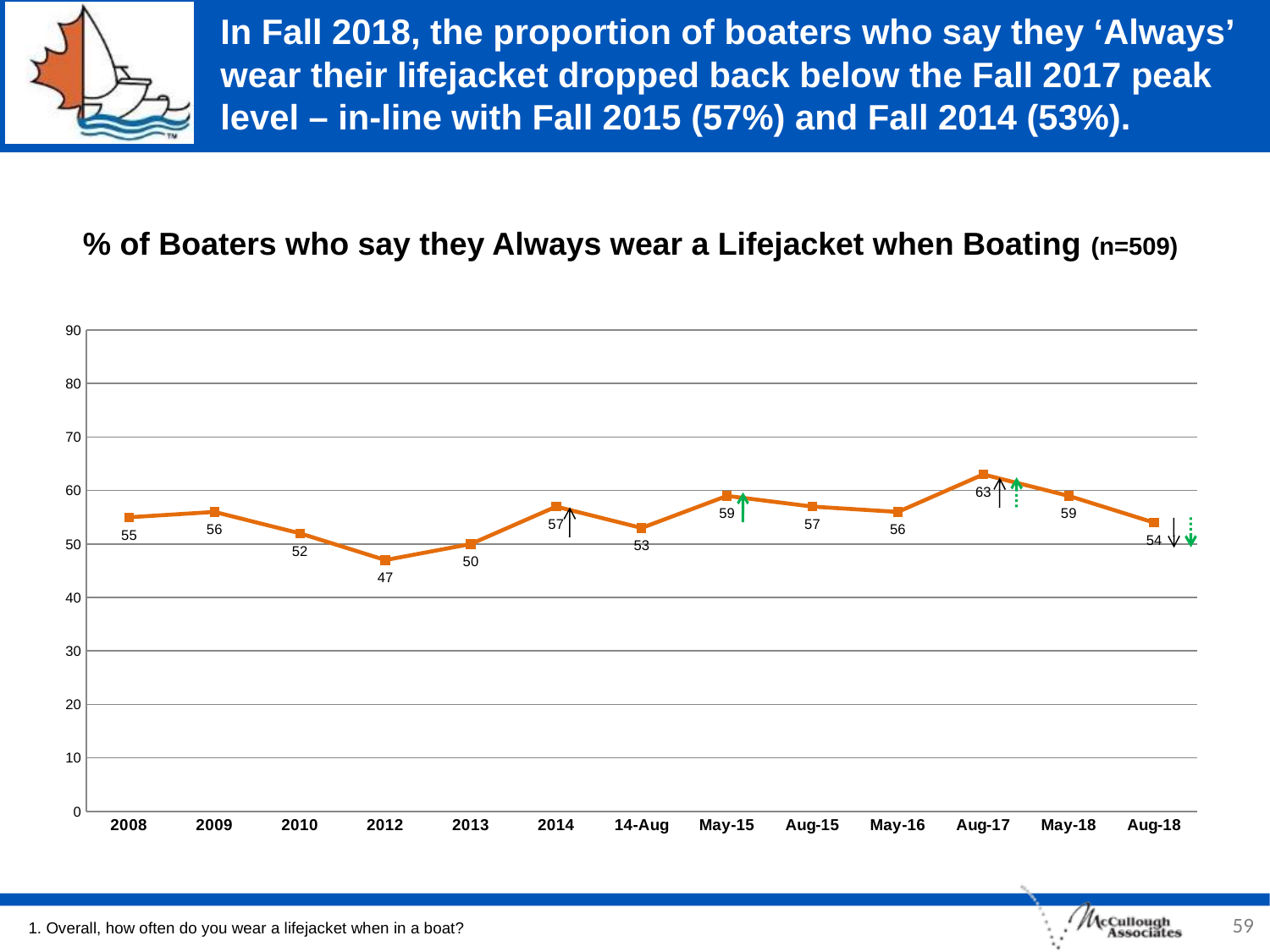
What is the sample size (n) shown in the chart title? n=509 Which time point has the lowest value? 2012 What type of chart is shown on the slide? line chart Does the value rise or fall from Aug-17 to Aug-18? fall Which time point has the highest value? Aug-17 Which is larger, the value for May-15 or the value for May-16? May-15 Is the value for 2012 greater or less than 50? less What is the difference between the Aug-17 value and the Aug-18 value? 9 What is the value for 2012? 47 What is the value for Aug-18? 54 What is the value for Aug-17? 63 How many time points are plotted on the x axis? 13